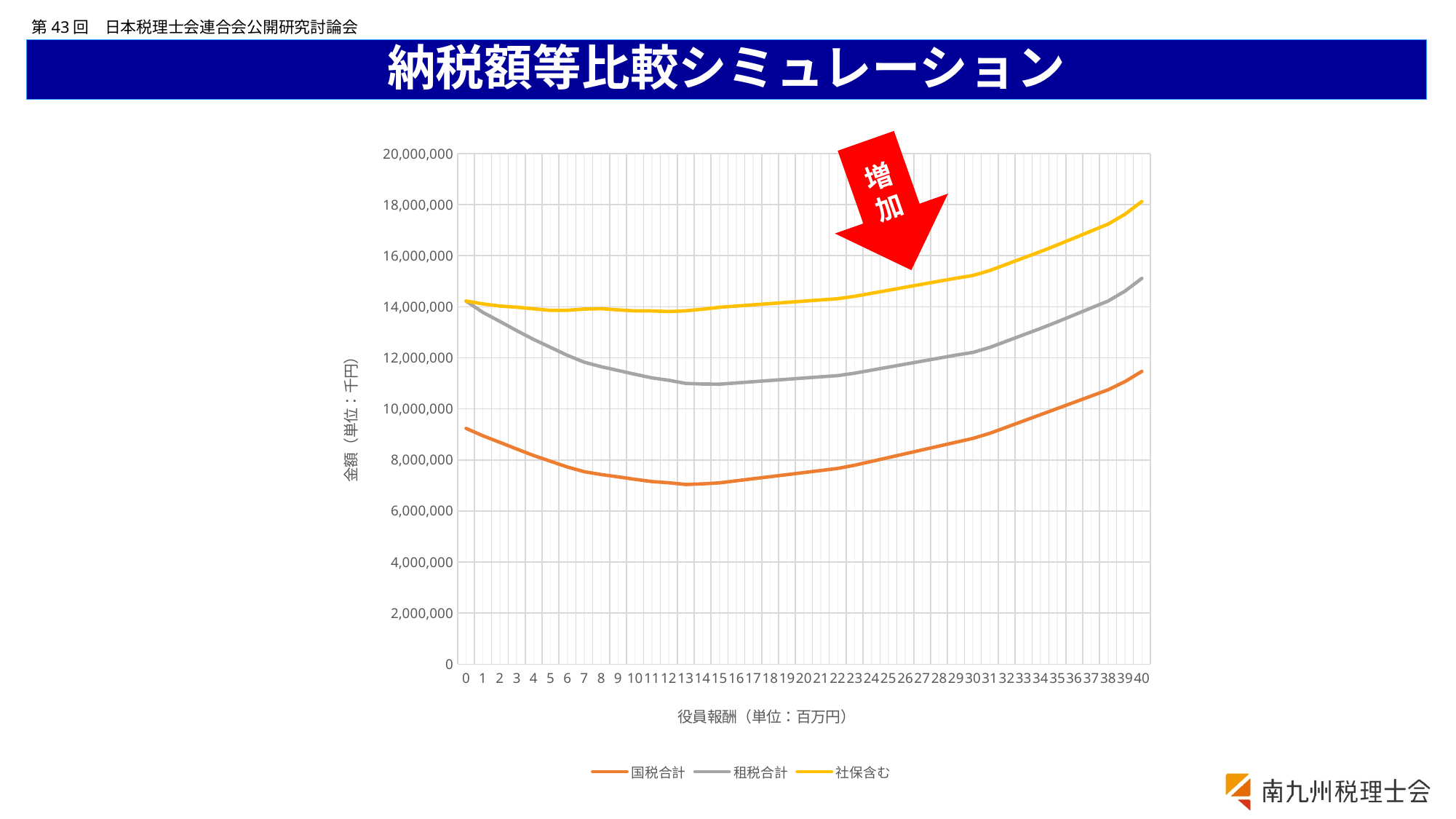
How many x-axis points (役員報酬 values from 0 to 40) are plotted for each series? 41 Is the value of 社保含む at 役員報酬 = 40 greater or less than 16,000,000? greater Which series has the lowest value across the whole chart? 国税合計 Is the value of 国税合計 at 役員報酬 = 0 greater or less than 8,000,000? greater At 役員報酬 = 0, which is larger: 租税合計 or 国税合計? 租税合計 Is the value of 租税合計 at 役員報酬 = 14 greater or less than 12,000,000? less What is the label of the x axis? 役員報酬（単位：百万円） What kind of chart is shown on the slide? line chart Which series has the highest value at 役員報酬 = 40? 社保含む Does the 社保含む line rise or fall between 役員報酬 = 20 and 役員報酬 = 40? rise How many series does the legend list? 3 Does the 国税合計 line rise or fall between 役員報酬 = 0 and 役員報酬 = 13? fall